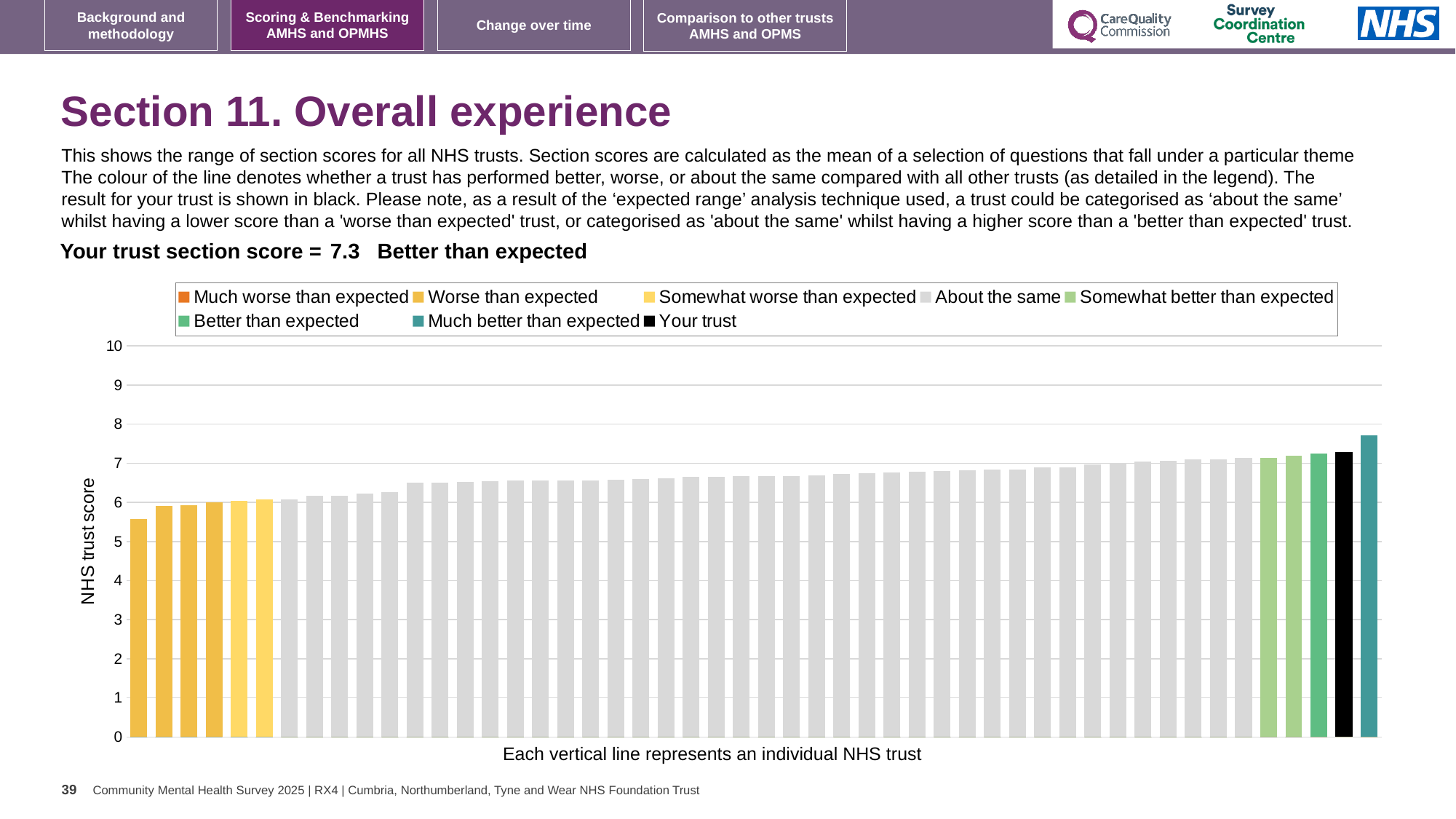
How many entries does the chart legend list? 8 Do the bar values rise or fall from left to right along the x axis? rise What kind of chart is shown on the slide? bar chart How many bars are coloured as 'Much better than expected'? 1 Is the value of the lowest bar in the chart greater or less than 6? less Which legend category does the highest bar in the chart belong to? Much better than expected Which is larger: the 'Your trust' bar or the 'Much better than expected' bar? Much better than expected Is the value for the black 'Your trust' bar greater or less than 7? greater Is the value of the highest bar in the chart greater or less than 8? less What is the section score for your trust shown on the slide? 7.3 What colour is used for the 'Your trust' bar in the chart? black What is the label on the vertical axis of the chart? NHS trust score